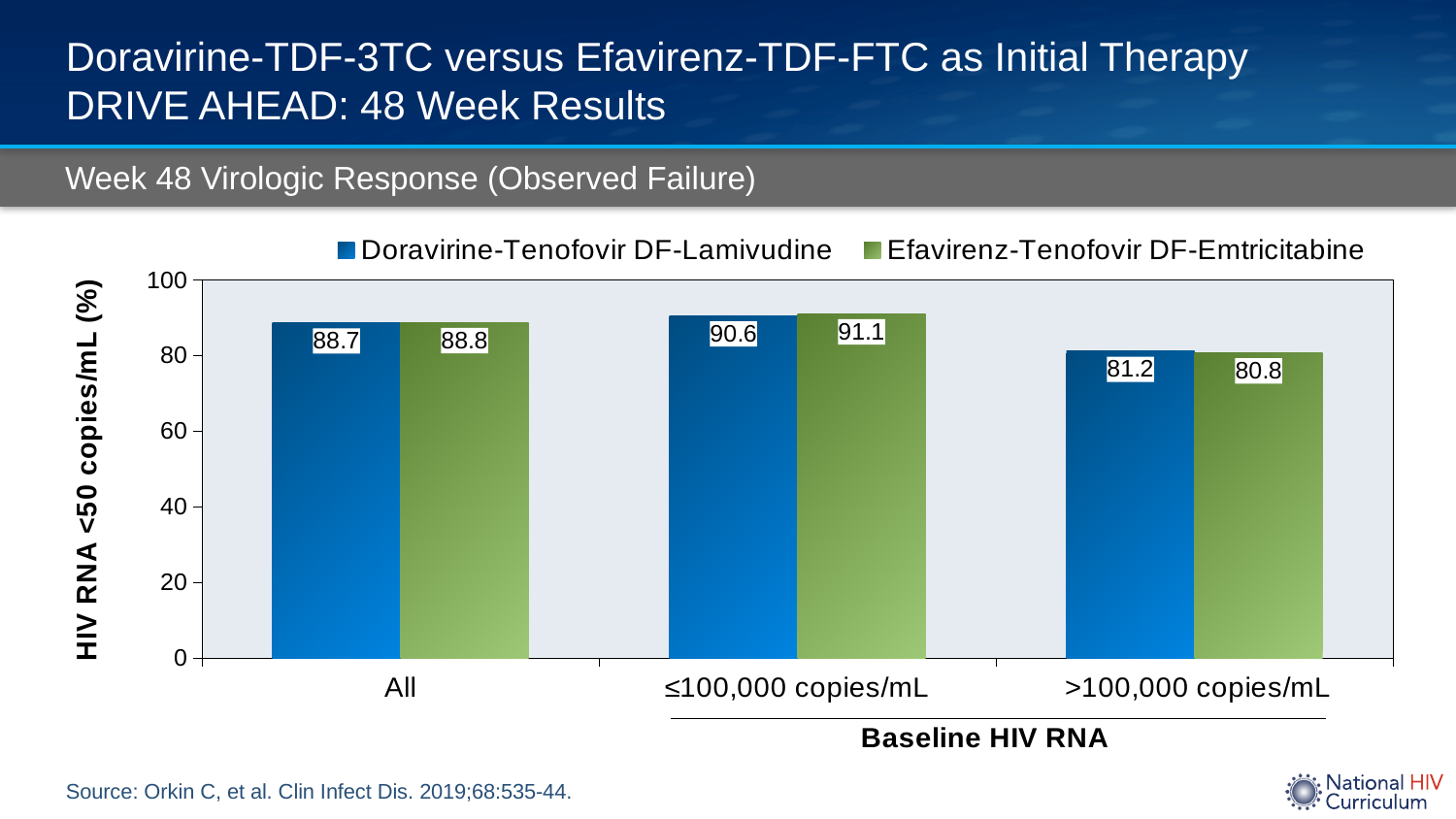
What is the difference between the two series in the >100,000 copies/mL category? 0.4 What is the value for Efavirenz-Tenofovir DF-Emtricitabine in the ≤100,000 copies/mL category? 91.1 Which baseline HIV RNA category has the highest value for Efavirenz-Tenofovir DF-Emtricitabine? ≤100,000 copies/mL What is the difference between the Doravirine-Tenofovir DF-Lamivudine values for ≤100,000 copies/mL and >100,000 copies/mL? 9.4 Is the value for Doravirine-Tenofovir DF-Lamivudine in the >100,000 copies/mL category greater or less than 80? greater What is the value for Doravirine-Tenofovir DF-Lamivudine in the All category? 88.7 Which baseline HIV RNA category has the lowest value for Doravirine-Tenofovir DF-Lamivudine? >100,000 copies/mL What kind of chart is shown on the slide? Bar chart How many series does the legend list? 2 What is the value for Efavirenz-Tenofovir DF-Emtricitabine in the >100,000 copies/mL category? 80.8 How many baseline HIV RNA categories are shown on the x axis? 3 What is the label of the y axis? HIV RNA <50 copies/mL (%)